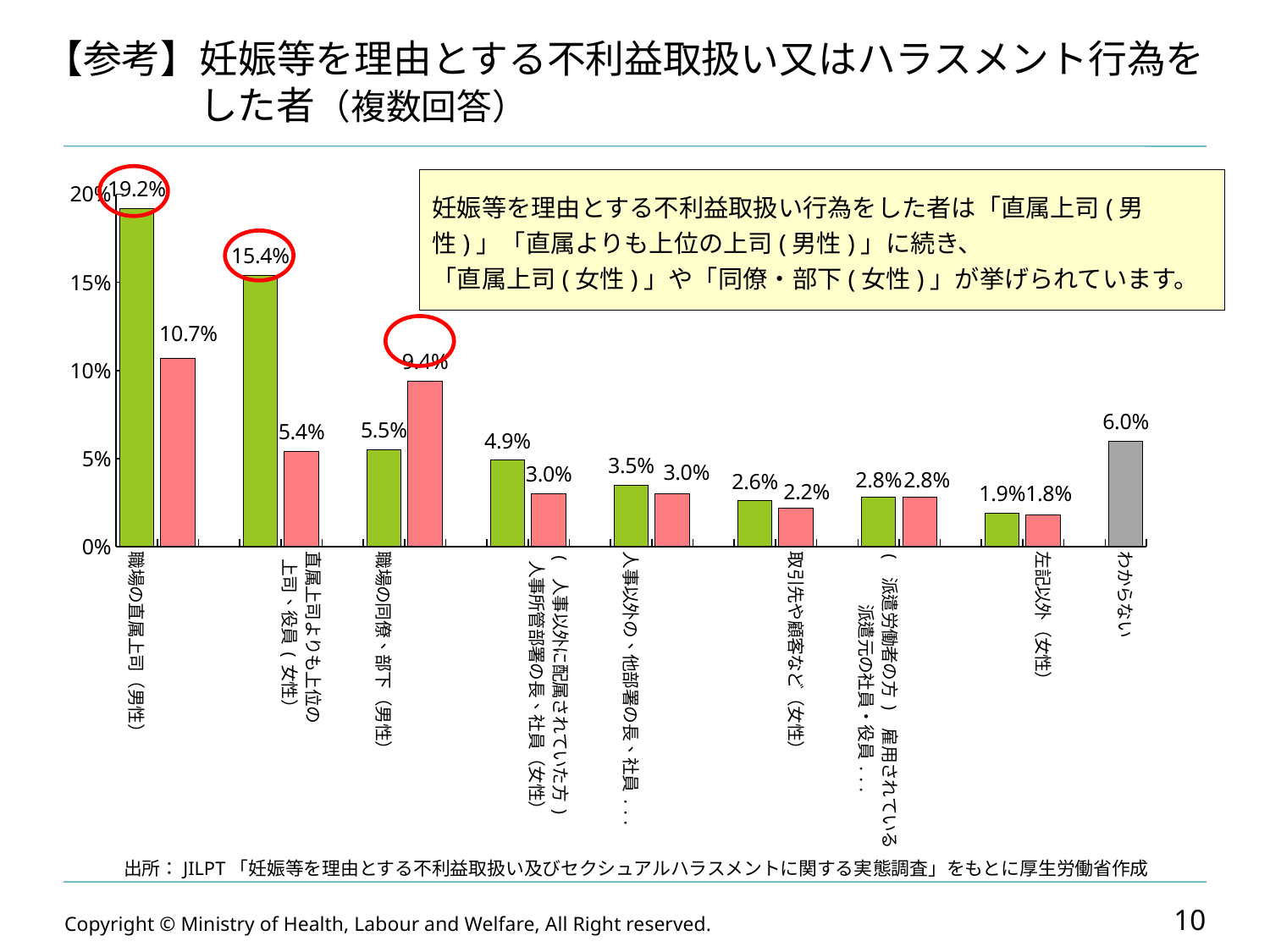
Is the value for 職場の直属上司（男性） greater or less than 15%? greater What is the value for 職場の直属上司（男性）? 19.2% What is the value for 直属上司よりも上位の上司・役員（女性）? 5.4% Which is larger, 職場の直属上司（男性） or わからない? 職場の直属上司（男性） What is the value for わからない? 6.0% Which category has the lowest value? 左記以外（女性） What colour is the bar for わからない? gray What is the value for 左記以外（女性）? 1.8% What kind of chart is shown on the slide? bar chart Which category has the highest value? 職場の直属上司（男性） What is the difference between 取引先や顧客など（女性） and 左記以外（女性）? 0.4 percentage points What is the difference between the 19.2% bar and the 15.4% bar? 3.8 percentage points